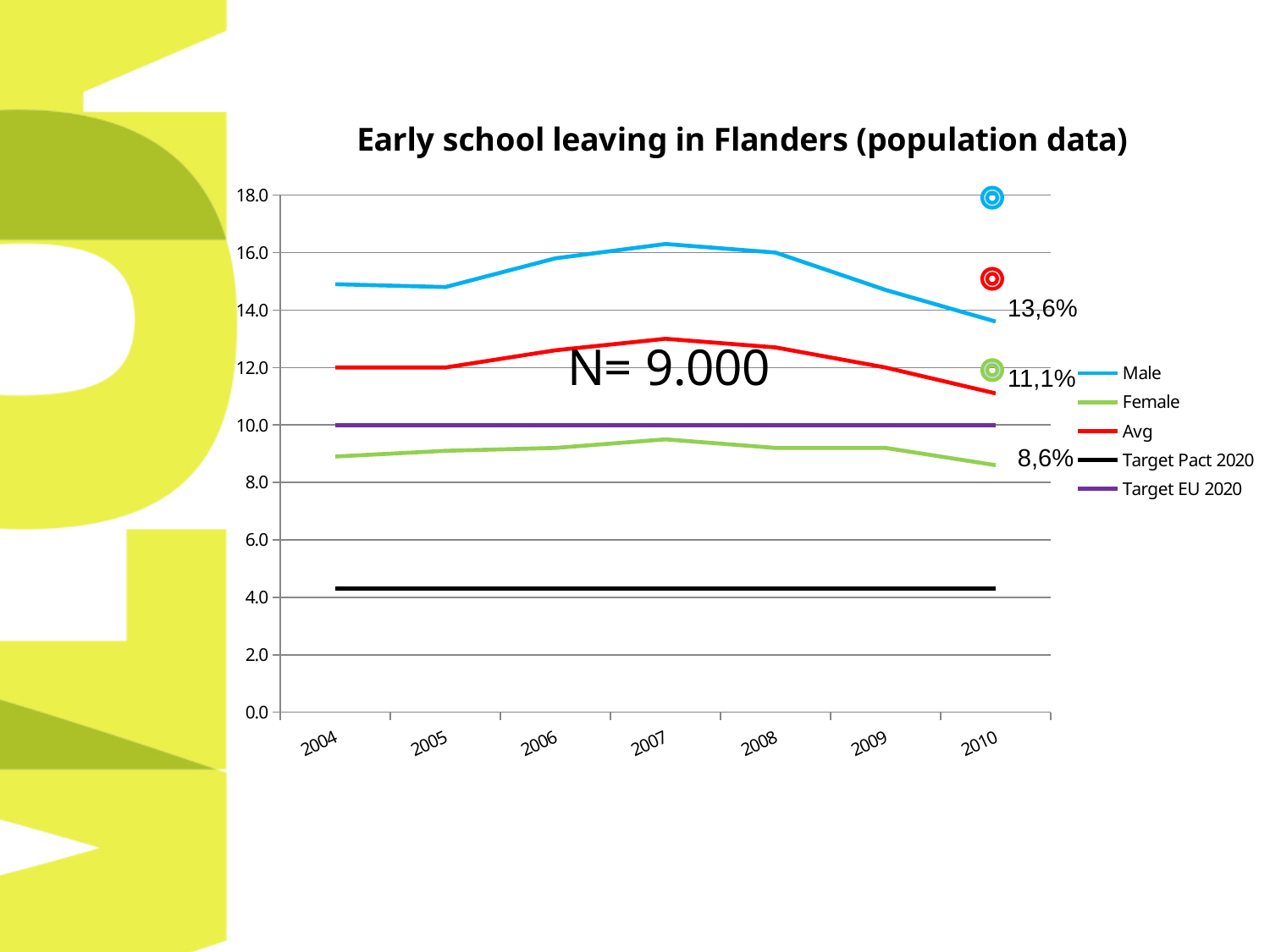
What is the value for Male in 2010? 13,6% Is the value for Male in 2004 greater or less than 14.0? greater What is the difference between the Male and Female values in 2010? 5,0% Is the value of the Target Pact 2020 line greater or less than 6.0? less How many series does the legend list? 5 What is the value for Avg in 2010? 11,1% Does the Male line rise or fall from 2008 to 2010? fall What is the value for Female in 2010? 8,6% How many years are shown on the x axis? 7 What kind of chart is shown on the slide? line chart What is the value of the Target EU 2020 line? 10.0 Which is larger in 2010, the Male value or the Female value? Male